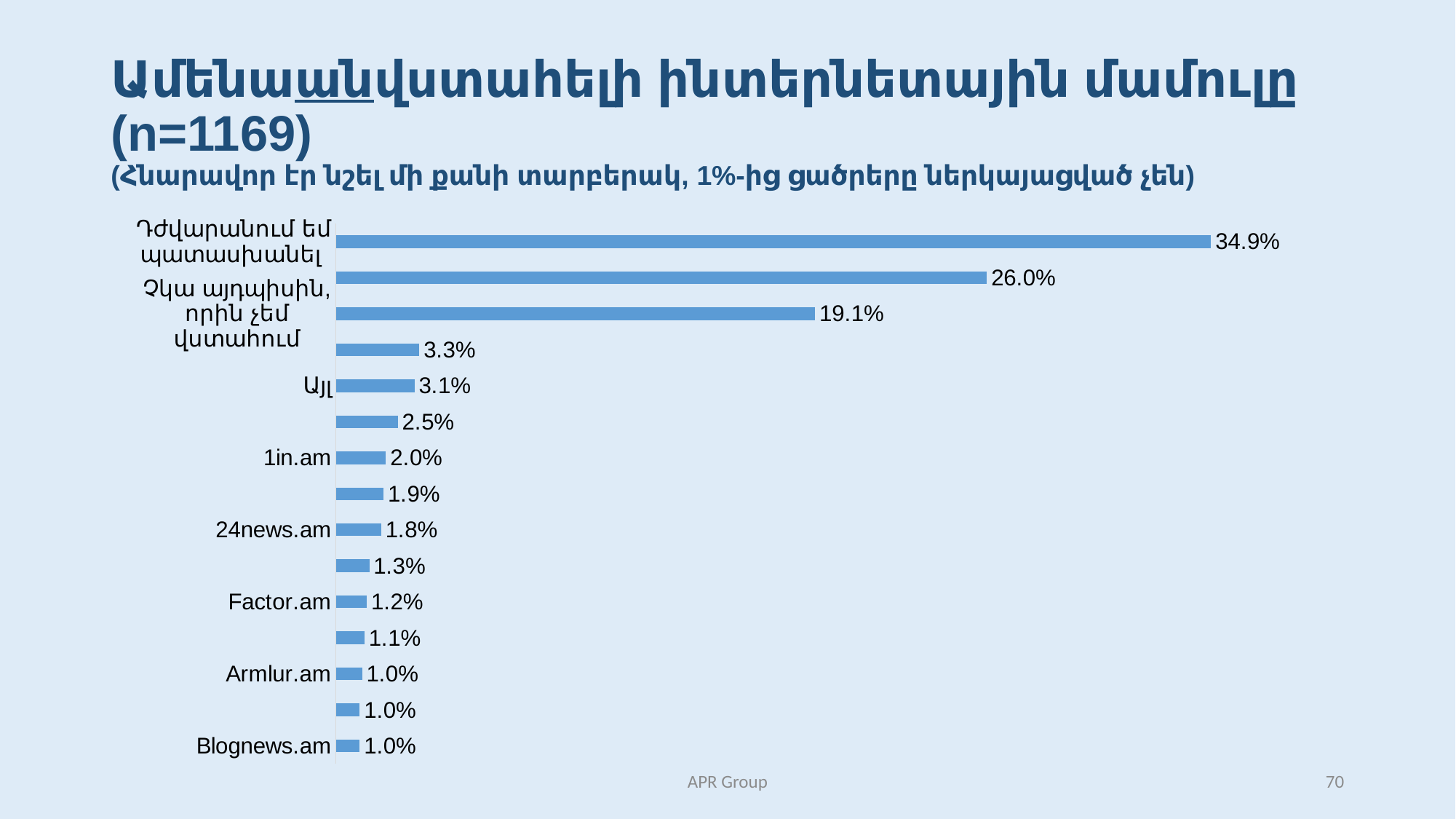
What is the value for Factor.am? 1.2% Which category has the highest value? Դժվարանում եմ պատասխանել What is the value for 1in.am? 2.0% What is the value for Blognews.am? 1.0% What kind of chart is shown on the slide? Bar chart What sample size (n) is stated in the slide title? n=1169 What is the difference between the largest bar (34.9%) and the second largest bar (26.0%)? 8.9 percentage points How many bars are plotted in the chart? 15 Which is larger, the value for 1in.am or the value for Factor.am? 1in.am What is the value for 24news.am? 1.8% What is the value for "Դժվարանում եմ պատասխանել"? 34.9% What is the lowest value shown in the chart? 1.0%